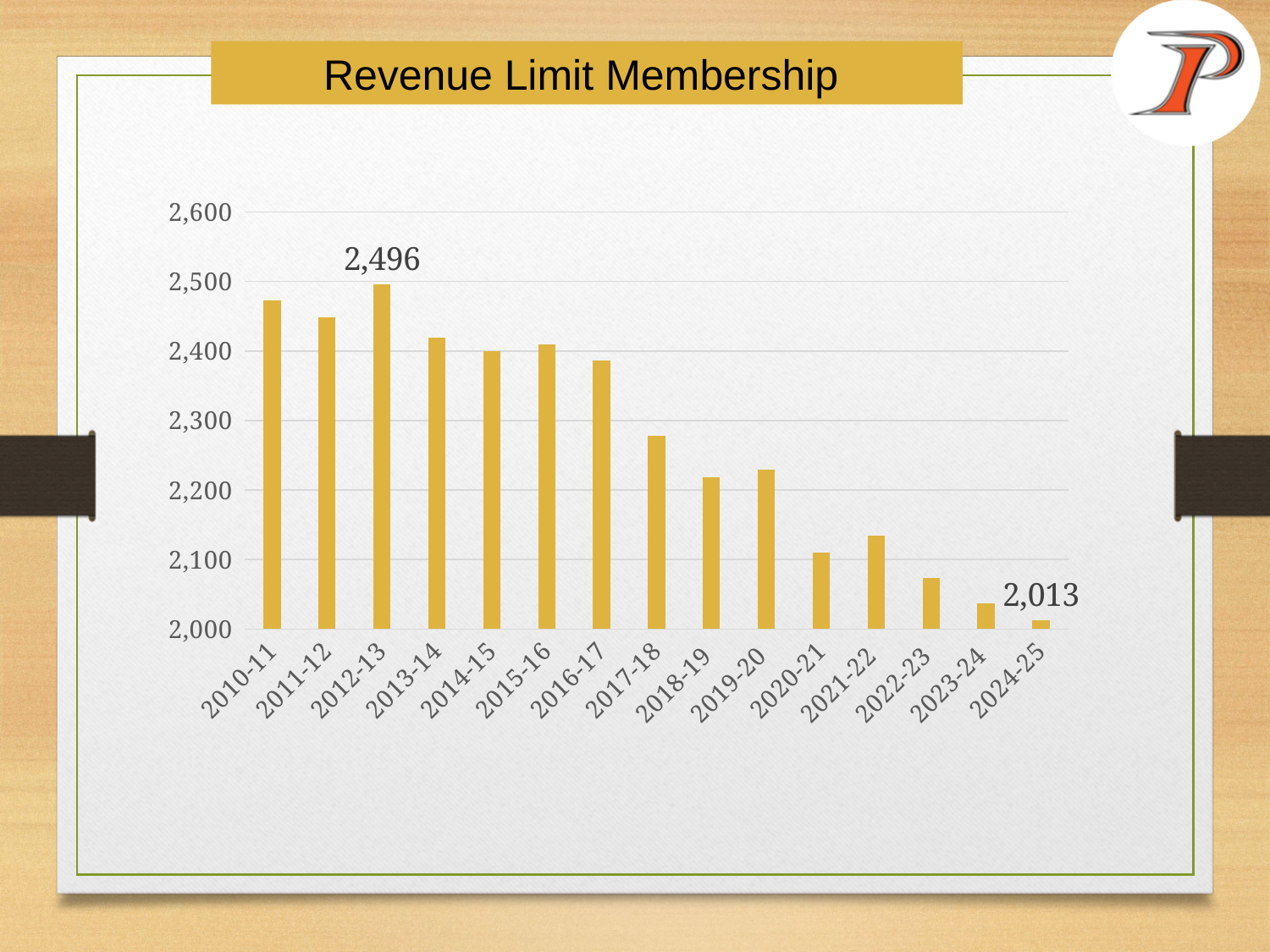
Is the value for 2020-21 greater or less than 2,200? less Is the value for 2010-11 greater or less than 2,400? greater Do the values generally rise or fall from 2010-11 to 2024-25? Fall What kind of chart is shown on the slide? Bar chart What is the title of the chart? Revenue Limit Membership Which year has the highest revenue limit membership? 2012-13 What is the value for 2024-25? 2,013 Which year has the lowest revenue limit membership? 2024-25 Which is larger, the value for 2016-17 or the value for 2017-18? 2016-17 How many years are shown on the x axis? 15 What is the value for 2012-13? 2,496 What is the difference between the values for 2012-13 and 2024-25? 483